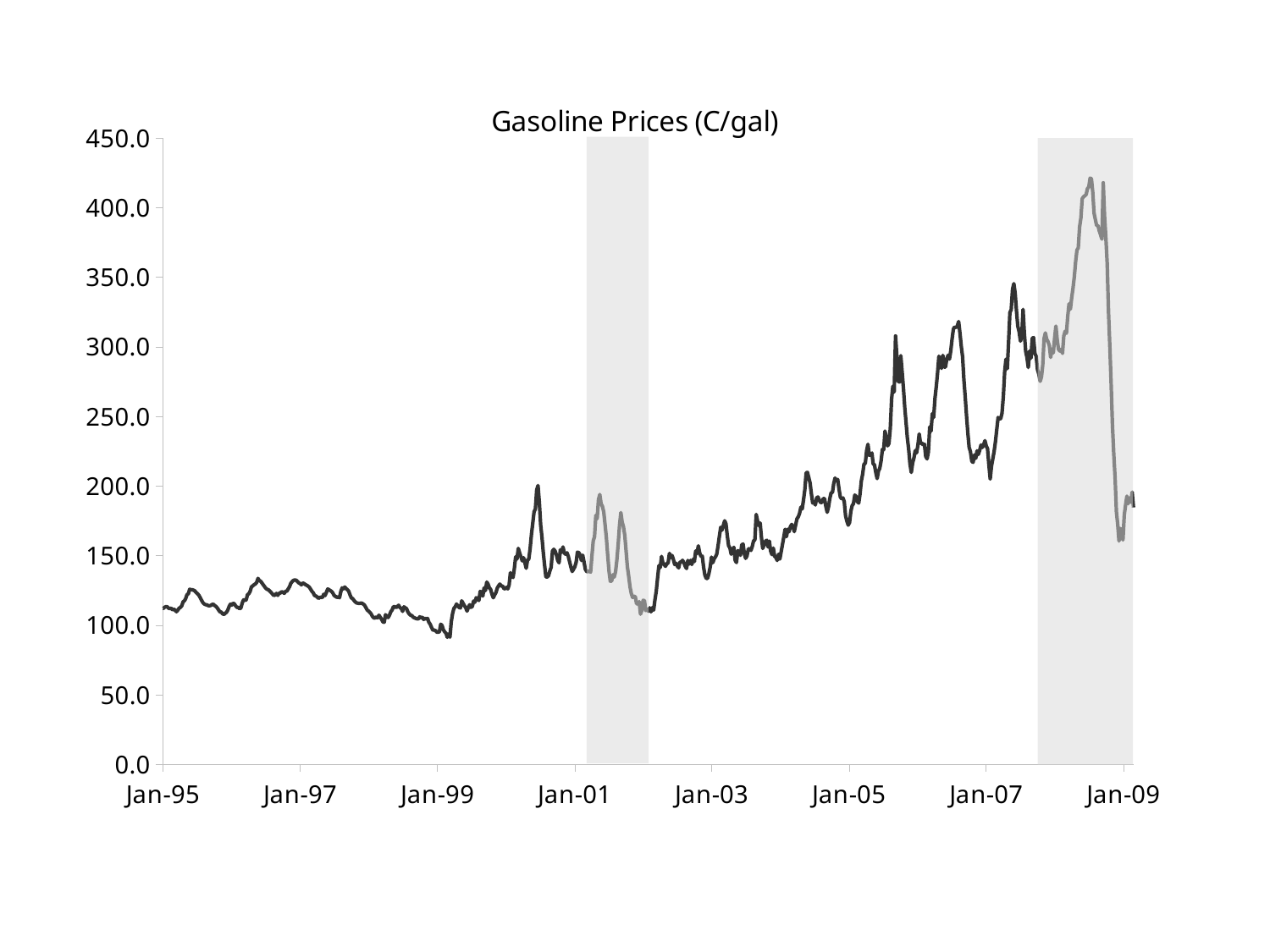
Is the value at Jan-09 greater or less than 250? less Do the values generally rise or fall between Jan-99 and Jan-07? rise Is the value at Jan-95 greater or less than 100? greater What kind of chart is shown on the slide? line chart In which year does the line reach its highest value? 2008 What is the title of the chart? Gasoline Prices (C/gal) How many shaded regions are drawn on the chart? 2 Which is larger, the value at Jan-97 or the value at Jan-05? Jan-05 Is the highest value reached by the line greater or less than 400? greater How many labelled tick marks are on the x axis? 8